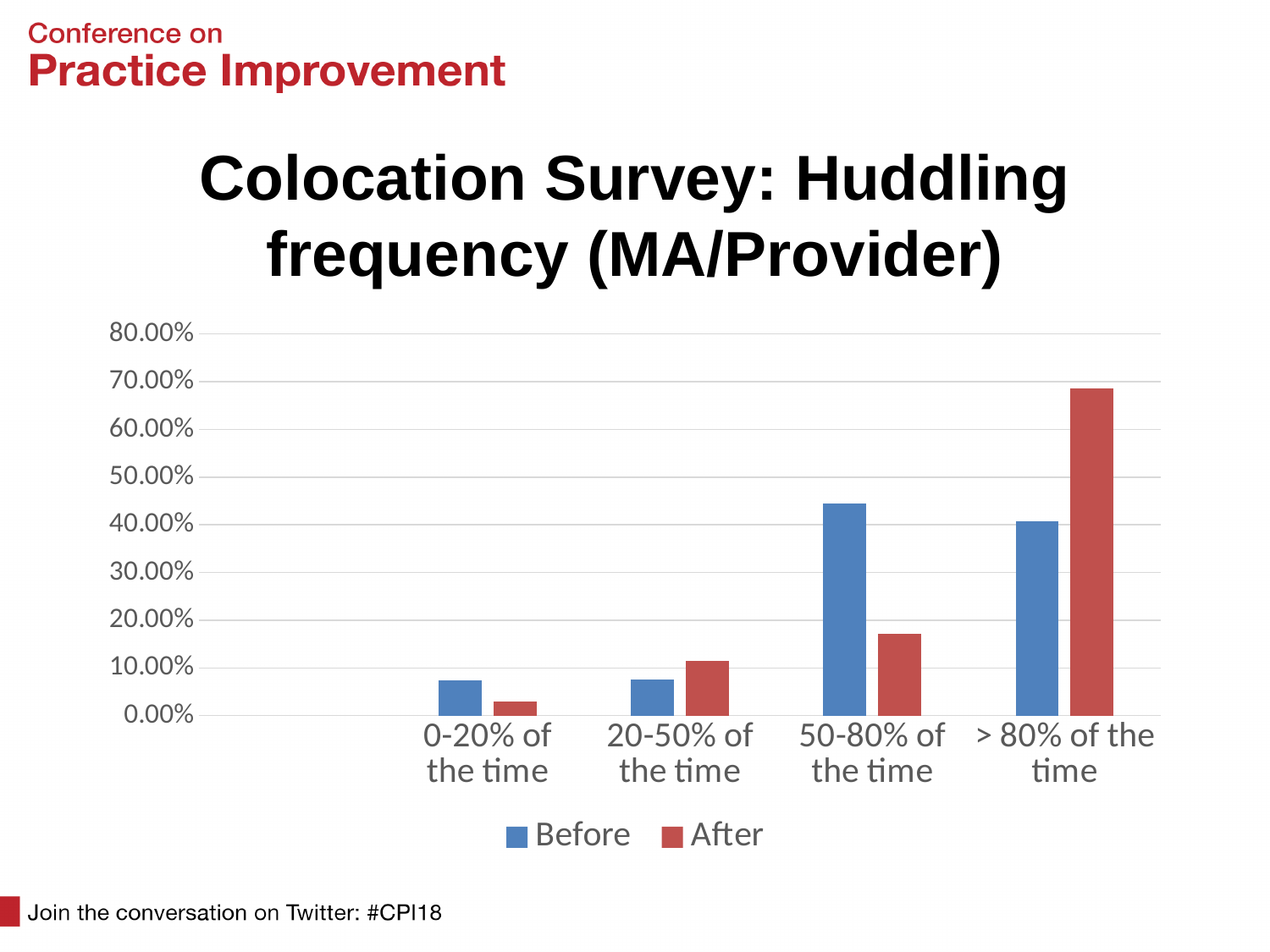
Do the After values rise or fall moving from 0-20% of the time to > 80% of the time? Rise Is the After value for 50-80% of the time greater or less than 20.00%? less Is the Before value for 50-80% of the time greater or less than 40.00%? greater How many series does the legend list? 2 How many huddling frequency categories are shown on the x axis? 4 For 50-80% of the time, which is larger, the Before value or the After value? Before For which category is the After value lowest? 0-20% of the time For > 80% of the time, which is larger, the Before value or the After value? After For which category is the Before value highest? 50-80% of the time Is the After value for > 80% of the time greater or less than 60.00%? greater For which category is the After value highest? > 80% of the time What kind of chart is shown on the slide? Bar chart